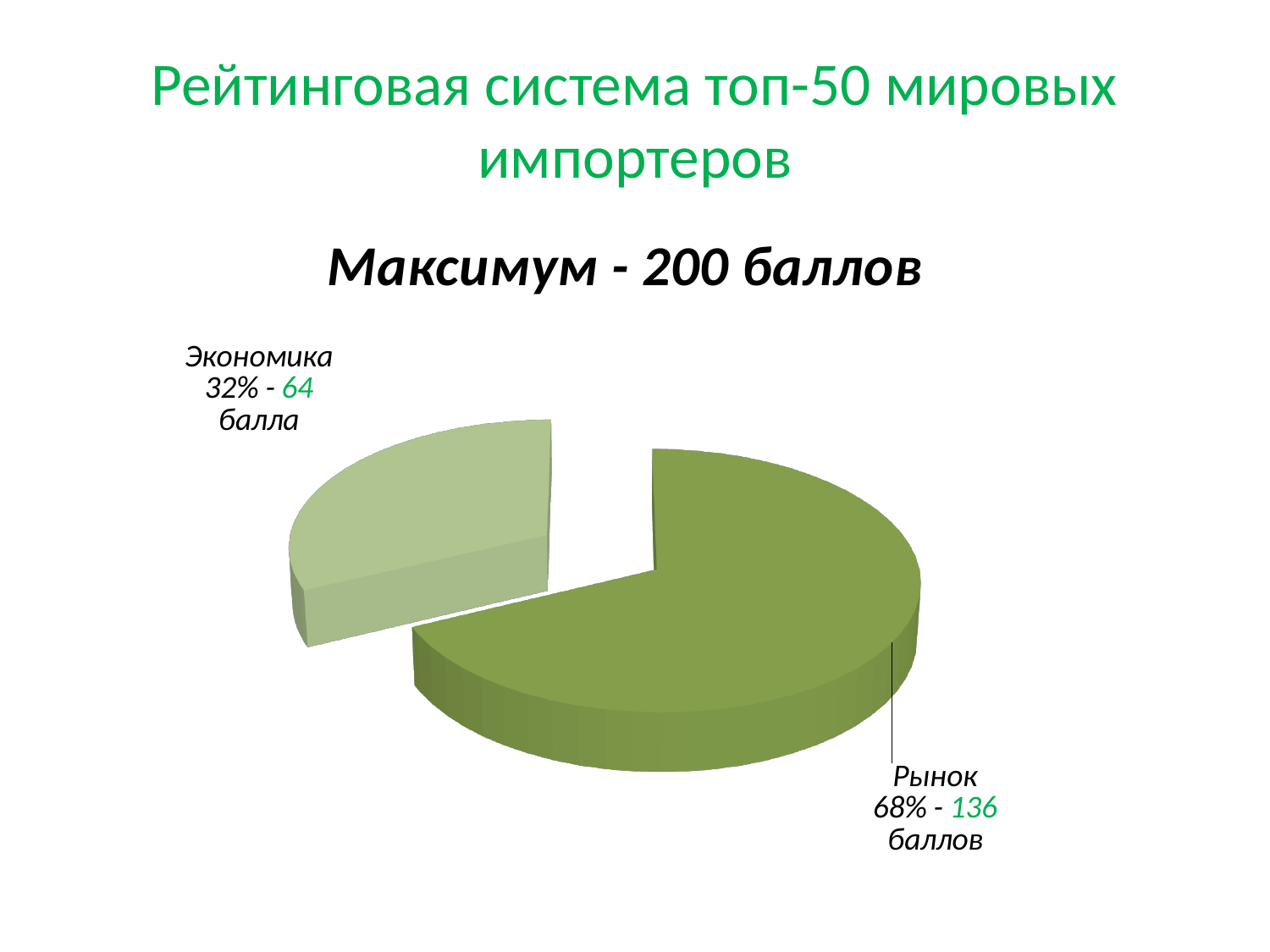
What is the total number of points across both slices? 200 What is the maximum score stated on the slide? 200 баллов What share of the pie does the Рынок slice represent? 68% What is the difference in points between Рынок and Экономика? 72 What share of the pie does the Экономика slice represent? 32% Which slice is the smallest in the pie chart? Экономика How many points (балла) are assigned to Экономика? 64 Which slice is the largest in the pie chart? Рынок How many points (баллов) are assigned to Рынок? 136 What kind of chart is shown on the slide? pie chart Which has a larger share, Рынок or Экономика? Рынок How many slices does the pie chart have? 2